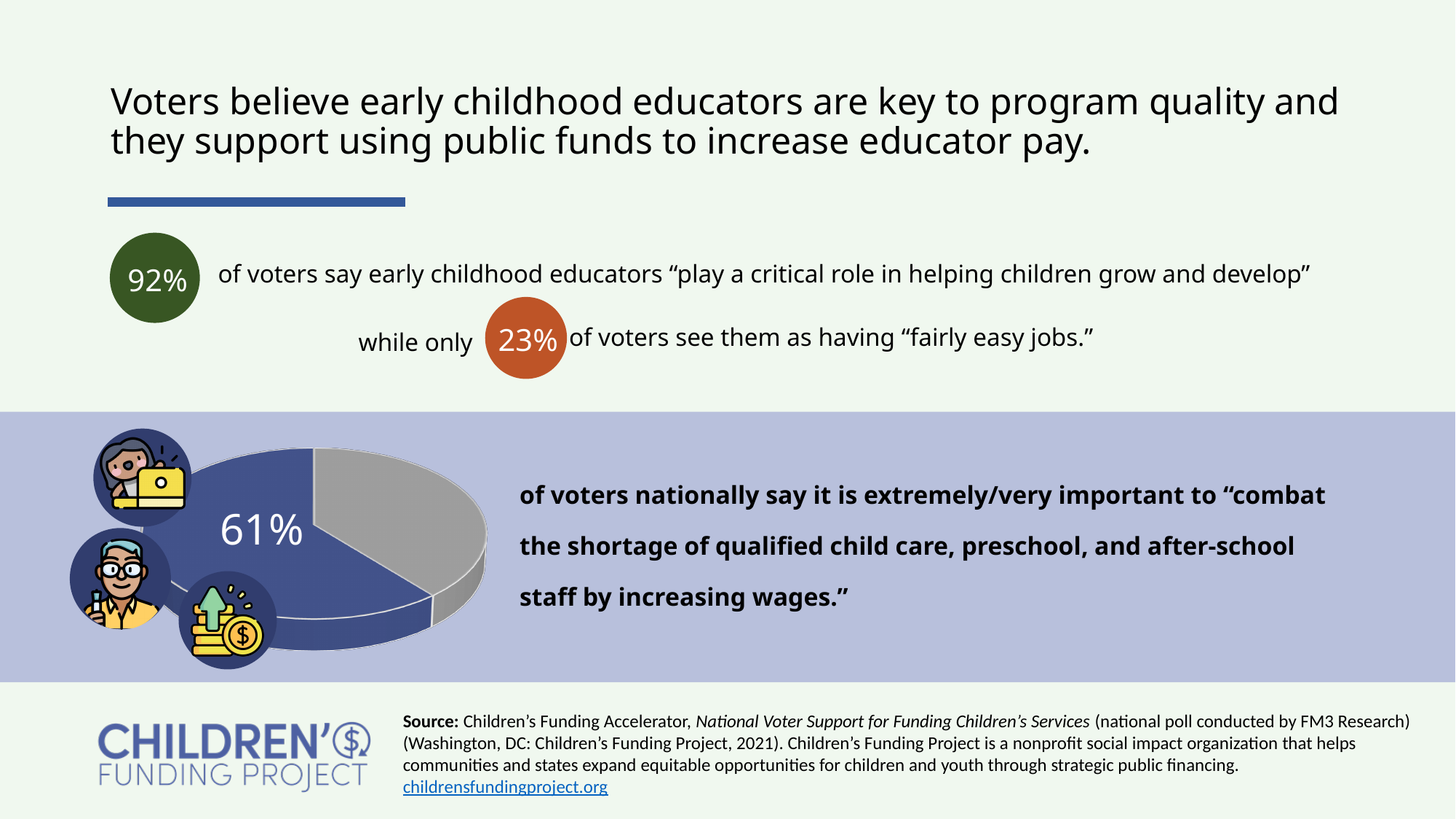
How many slices does the pie chart have? 2 Is the blue slice of the pie chart greater or less than 50% of the pie? greater Is the gray slice of the pie chart greater or less than 50% of the pie? less What colour is the slice of the pie chart labeled 61%? blue Does the pie chart include a legend? No What percentage is labeled on the blue slice of the pie chart? 61% What kind of chart is shown on the slide? pie chart What share of voters nationally say it is extremely/very important to combat the staff shortage by increasing wages, according to the pie chart? 61% Which slice of the pie chart is larger, the blue slice or the gray slice? the blue slice